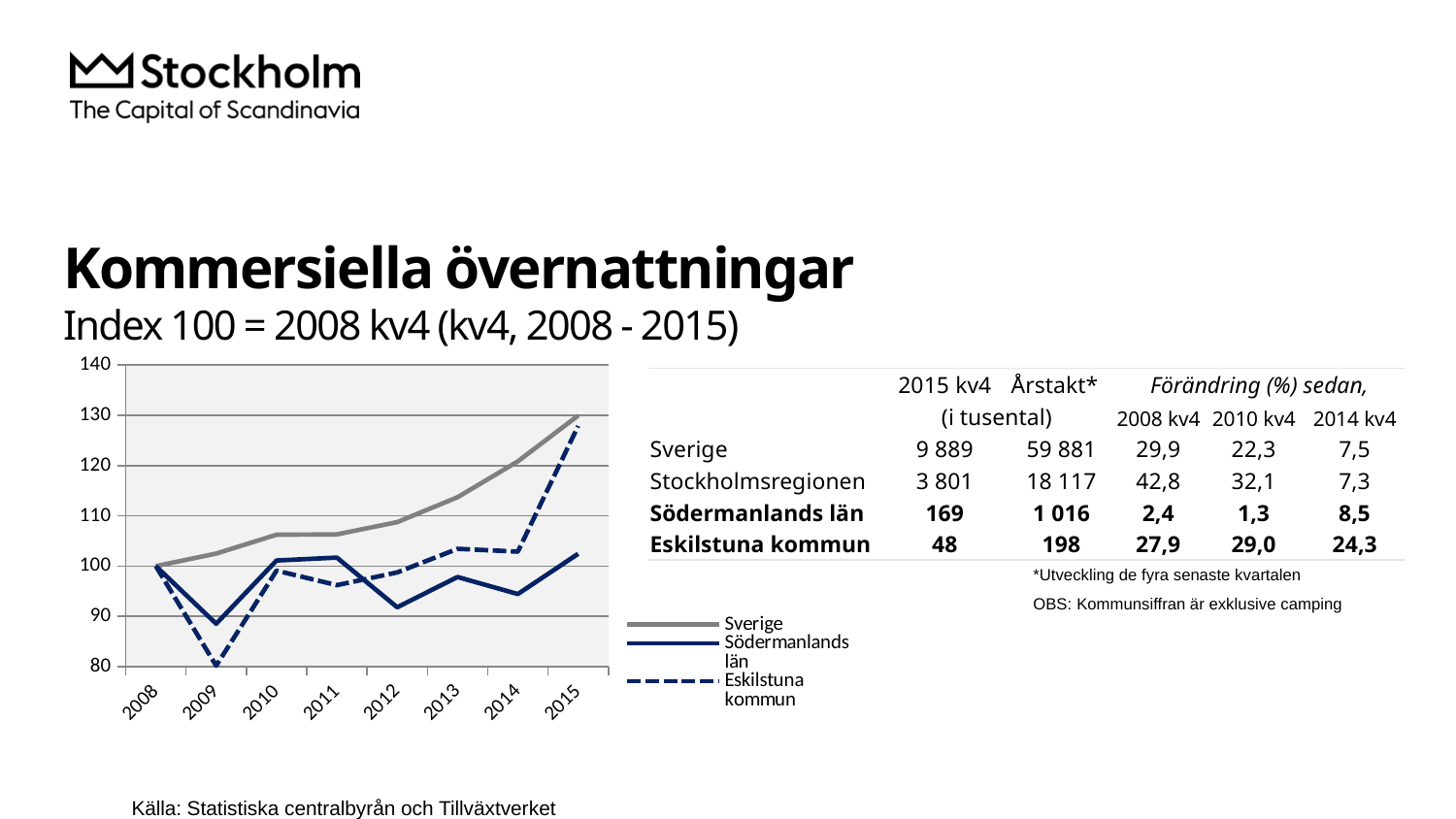
Is the value for Eskilstuna kommun in 2009 greater or less than 90? less How many years are shown along the x axis of the chart? 8 Is the value for Sverige in 2015 greater or less than 120? greater Is the value for Sverige in 2014 greater or less than 110? greater In 2015, which is larger: the value for Sverige or the value for Södermanlands län? Sverige What kind of chart is shown on the slide? line chart Which series has the highest value in 2015? Sverige Does the Sverige line rise or fall from 2008 to 2015? rise What is the title of the chart on the slide? Kommersiella övernattningar How many series does the chart legend list? 3 Which series has the lowest value in 2009? Eskilstuna kommun